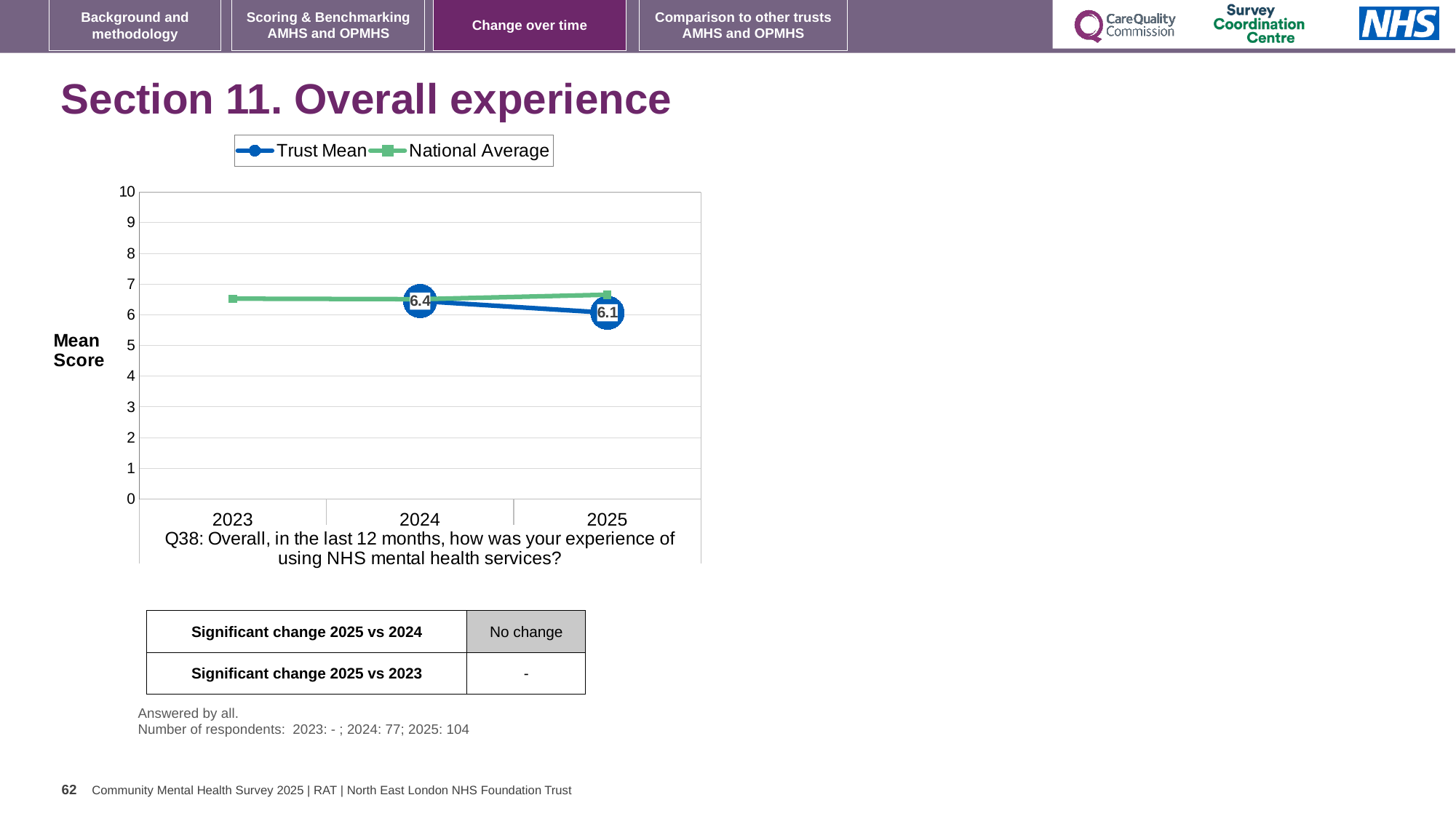
Is the National Average value for 2025 greater or less than 7? less How many series does the legend list? 2 What are the two series named in the legend? Trust Mean and National Average What kind of chart is shown on the slide? line chart By how much did the Trust Mean change between 2024 and 2025? 0.3 What is the Trust Mean value for 2024? 6.4 Is the National Average value for 2023 greater or less than 6? greater What is the Trust Mean value for 2025? 6.1 What is the label on the y axis? Mean Score Does the Trust Mean rise or fall from 2024 to 2025? fall How many years are shown on the x axis? 3 Which year has the higher Trust Mean, 2024 or 2025? 2024